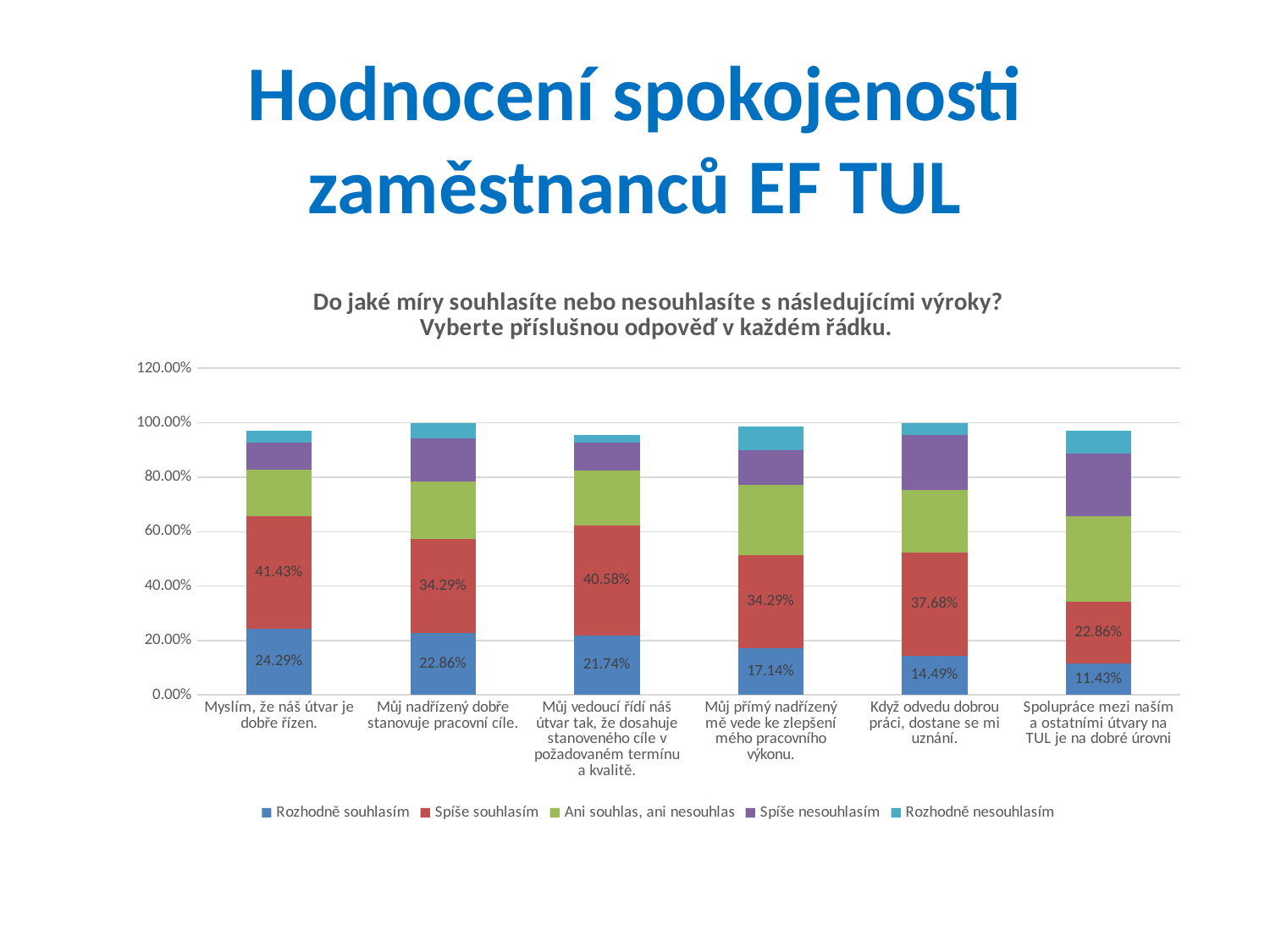
Which has the larger "Rozhodně souhlasím" value: "Můj přímý nadřízený mě vede ke zlepšení mého pracovního výkonu." or "Když odvedu dobrou práci, dostane se mi uznání."? Můj přímý nadřízený mě vede ke zlepšení mého pracovního výkonu. How many statements (categories) are shown on the x axis? 6 What is the difference between the "Spíše souhlasím" and "Rozhodně souhlasím" values for "Myslím, že náš útvar je dobře řízen."? 17.14% What is the value of "Rozhodně souhlasím" for "Myslím, že náš útvar je dobře řízen."? 24.29% Is the top of the stacked bar for "Můj vedoucí řídí náš útvar tak, že dosahuje stanoveného cíle v požadovaném termínu a kvalitě." greater or less than 100.00%? less Which statement has the highest "Rozhodně souhlasím" value? Myslím, že náš útvar je dobře řízen. What kind of chart is shown on the slide? stacked bar chart What is the value of "Spíše souhlasím" for "Když odvedu dobrou práci, dostane se mi uznání."? 37.68% Which statement has the lowest "Spíše souhlasím" value? Spolupráce mezi naším a ostatními útvary na TUL je na dobré úrovni What is the value of "Spíše souhlasím" for "Spolupráce mezi naším a ostatními útvary na TUL je na dobré úrovni"? 22.86% What colour represents "Spíše souhlasím" in the legend? red How many series does the legend list? 5